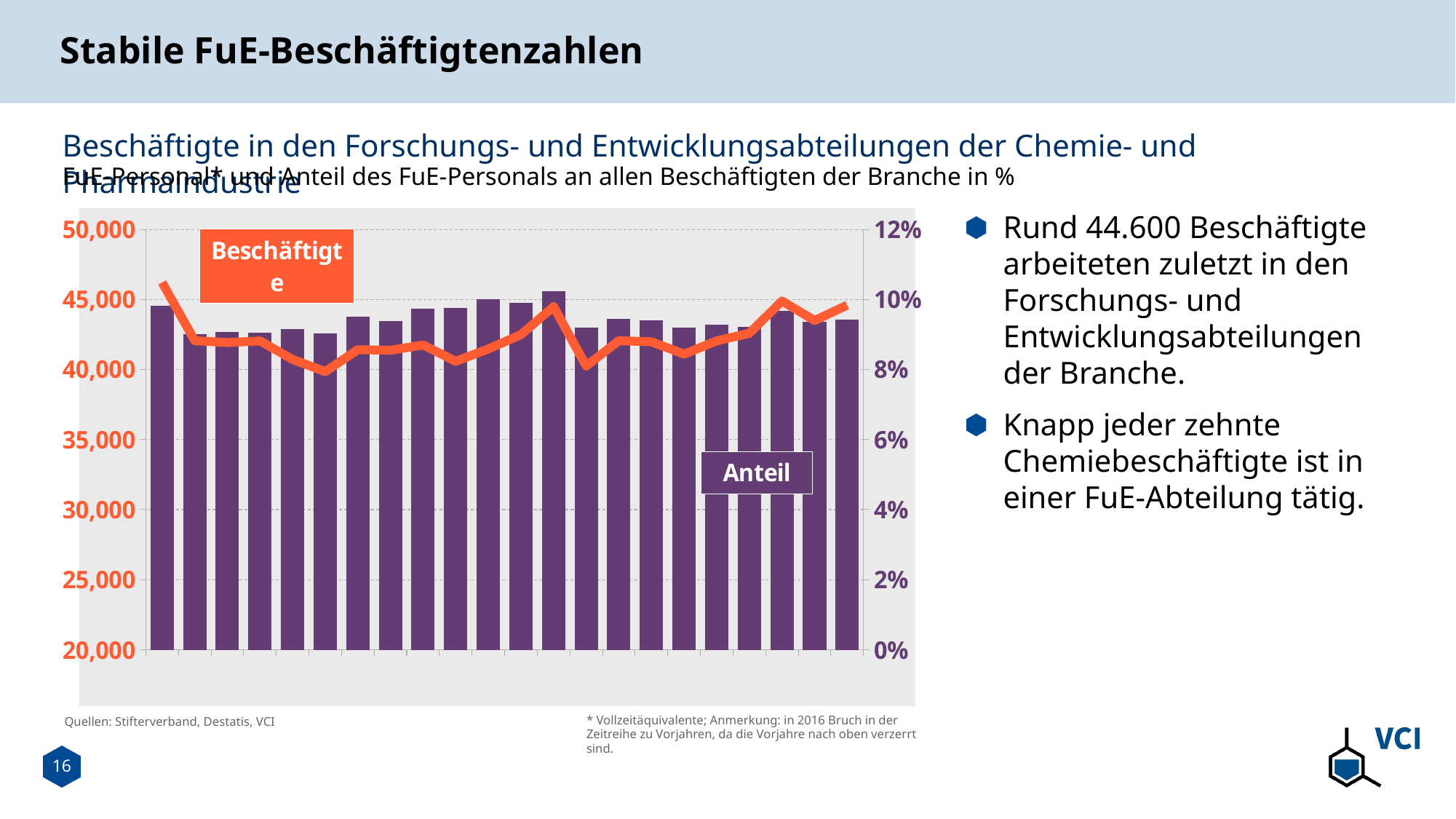
Is the lowest point of the Anteil line greater or less than 10%? less What colour are the bars for Beschäftigte? Purple Is the value of the tallest Beschäftigte bar greater or less than 45,000? greater What are the names of the two series shown in the chart? Beschäftigte and Anteil What kind of chart is shown on the slide? A bar chart combined with a line What is the highest value shown on the right axis? 12% Is the first point of the Anteil line greater or less than 10%? greater How many data series does the chart show? 2